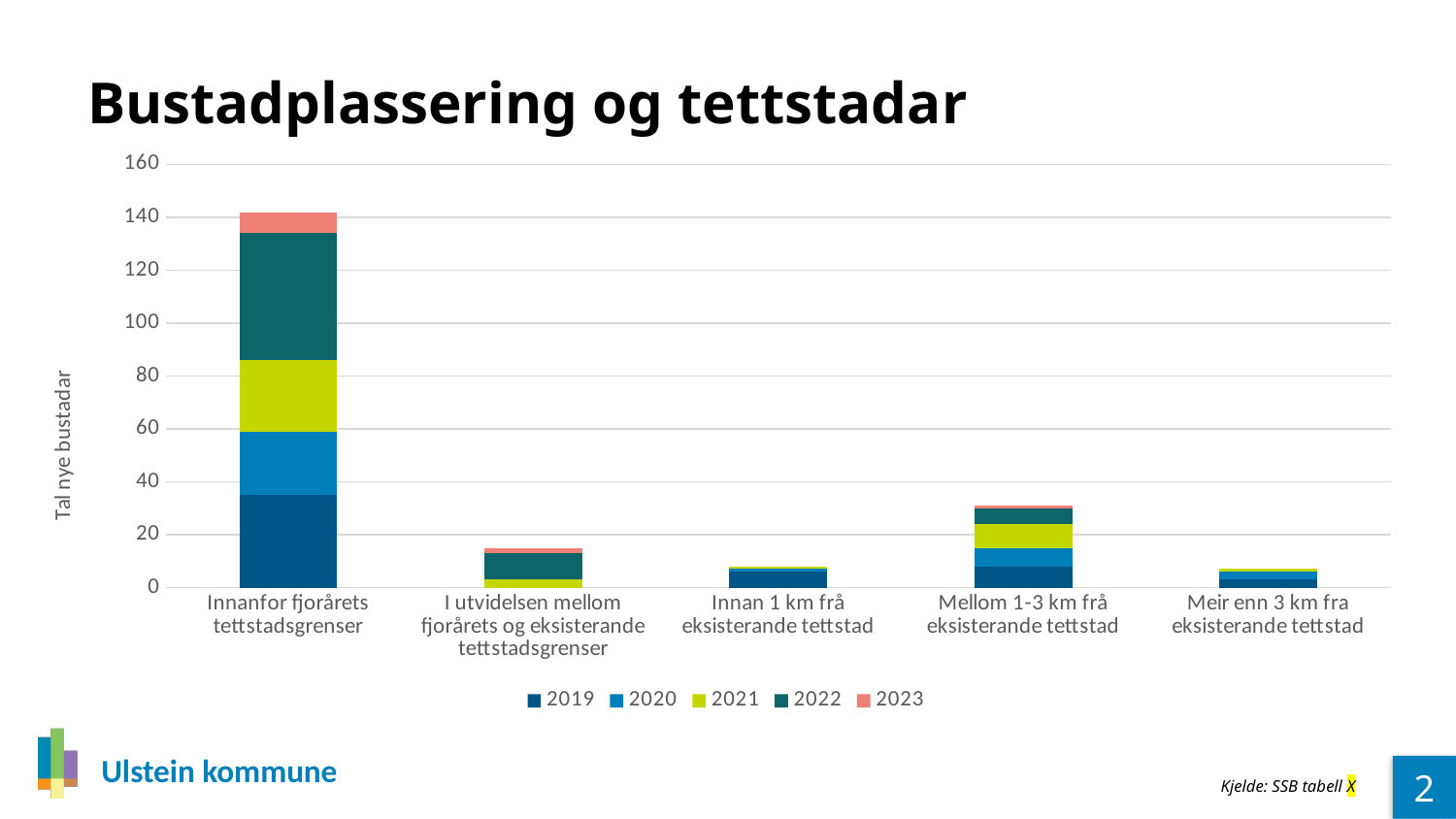
Is the total stacked value for 'I utvidelsen mellom fjorårets og eksisterande tettstadsgrenser' greater or less than 20? less Which category has the highest total stacked bar? Innanfor fjorårets tettstadsgrenser What kind of chart is shown on the slide? Stacked bar chart How many series does the legend list? 5 Is the total stacked value for 'Mellom 1-3 km frå eksisterande tettstad' greater or less than 20? greater Is the total stacked value for 'Mellom 1-3 km frå eksisterande tettstad' greater or less than 40? less Which has the larger total stacked bar: 'Mellom 1-3 km frå eksisterande tettstad' or 'I utvidelsen mellom fjorårets og eksisterande tettstadsgrenser'? Mellom 1-3 km frå eksisterande tettstad How many categories are shown along the x axis of the chart? 5 What is the title of the chart on the slide? Bustadplassering og tettstadar What is the label on the y axis of the chart? Tal nye bustadar